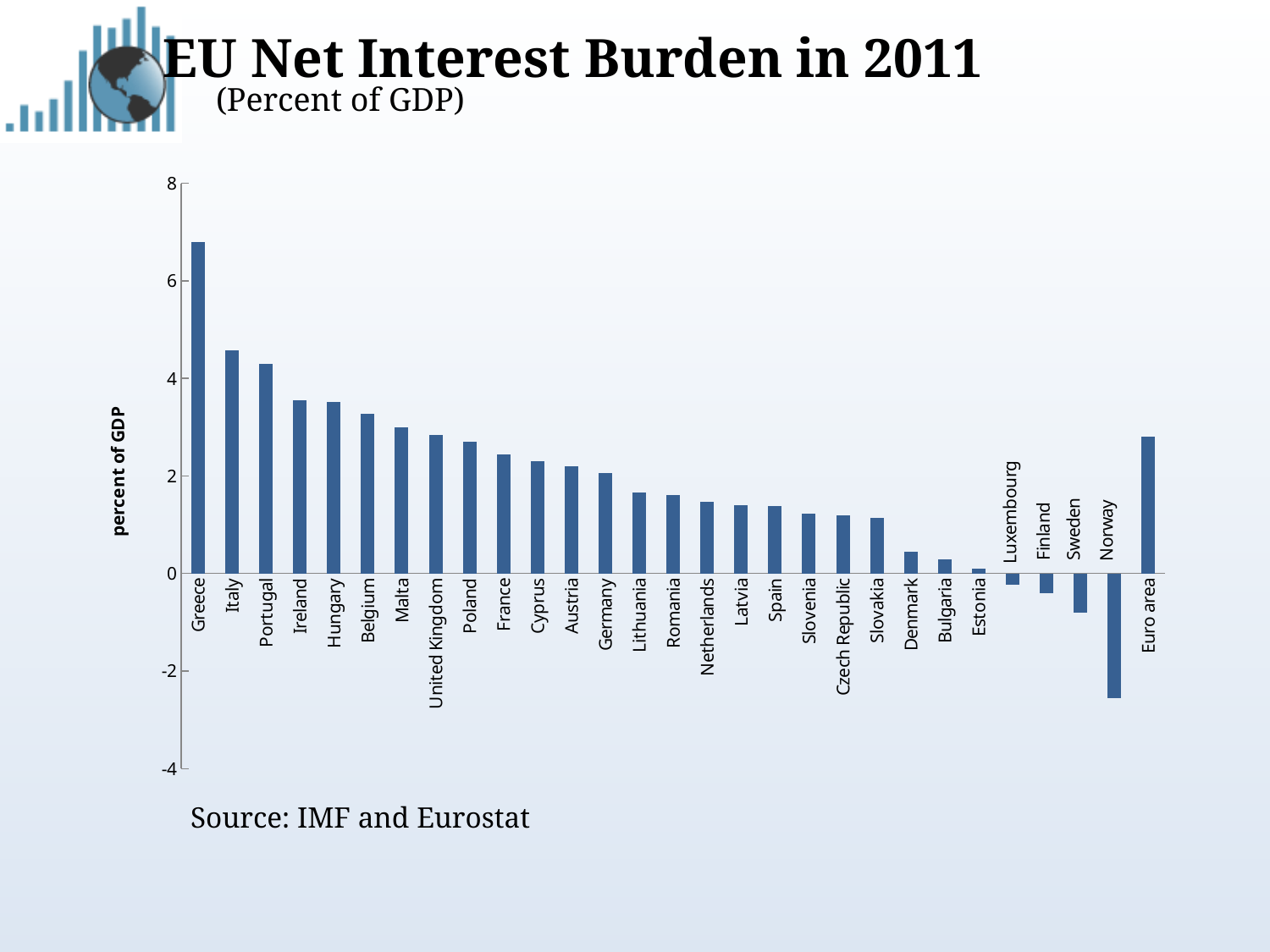
Is the value for Italy greater or less than 4? greater Is the value for Greece greater or less than 6? greater Is the value for Spain greater or less than 2? less How many bars are plotted in the chart? 29 What kind of chart is shown on the slide? bar chart Do the values for the individual countries rise or fall from left to right across the chart? fall Which has the larger net interest burden, Portugal or Ireland? Portugal What is the label on the vertical axis of the chart? percent of GDP Which country has the highest net interest burden in the chart? Greece Which country has the lowest (most negative) net interest burden in the chart? Norway